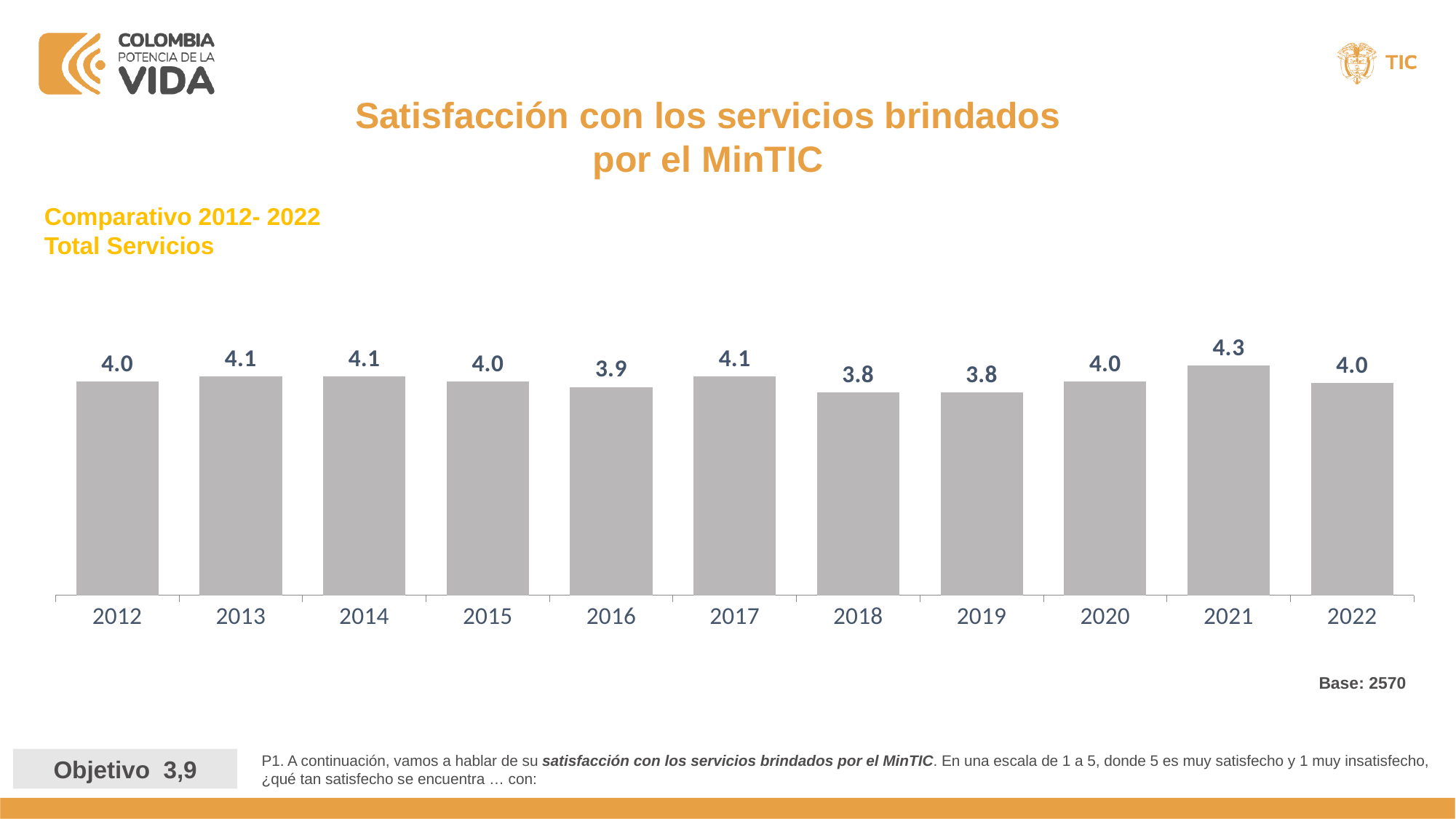
Which is larger, the value for 2014 or the value for 2019? 2014 What is the difference between the values for 2017 and 2016? 0.2 What is the base (sample size) shown on the slide? 2570 Which is larger, the value for 2021 or the value for 2022? 2021 What is the satisfaction value for 2016? 3.9 How many years are shown on the chart? 11 Which year has the highest satisfaction value? 2021 What is the satisfaction value for 2021? 4.3 What is the difference between the values for 2021 and 2018? 0.5 What is the satisfaction value for 2022? 4.0 What kind of chart is shown on the slide? Bar chart Do the values rise or fall from 2017 to 2018? Fall